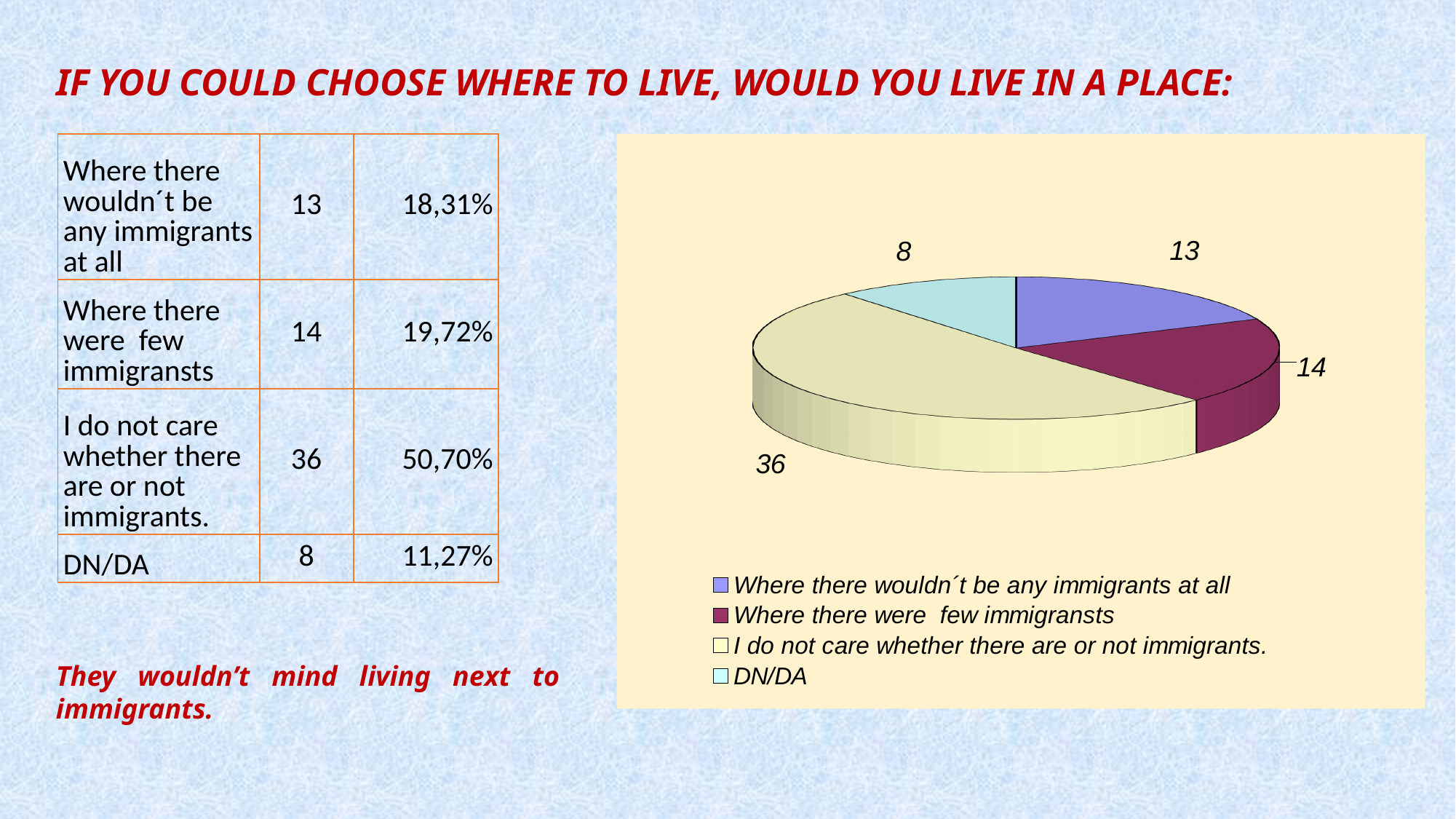
Which is larger: the value for "Where there were few immigransts" or the value for "Where there wouldn´t be any immigrants at all"? Where there were few immigransts What is the value for DN/DA in the pie chart? 8 What is the value for "Where there wouldn´t be any immigrants at all" in the pie chart? 13 What is the value for "I do not care whether there are or not immigrants." in the pie chart? 36 How many slices does the pie chart have? 4 What share of the pie does "I do not care whether there are or not immigrants." represent? 50,70% Which category has the largest slice in the pie chart? I do not care whether there are or not immigrants. What type of chart is shown on the slide? pie chart What is the difference between the value for "I do not care whether there are or not immigrants." and the value for DN/DA? 28 What colour is the slice for DN/DA in the pie chart? light blue Which category has the smallest slice in the pie chart? DN/DA What is the value for "Where there were few immigransts" in the pie chart? 14